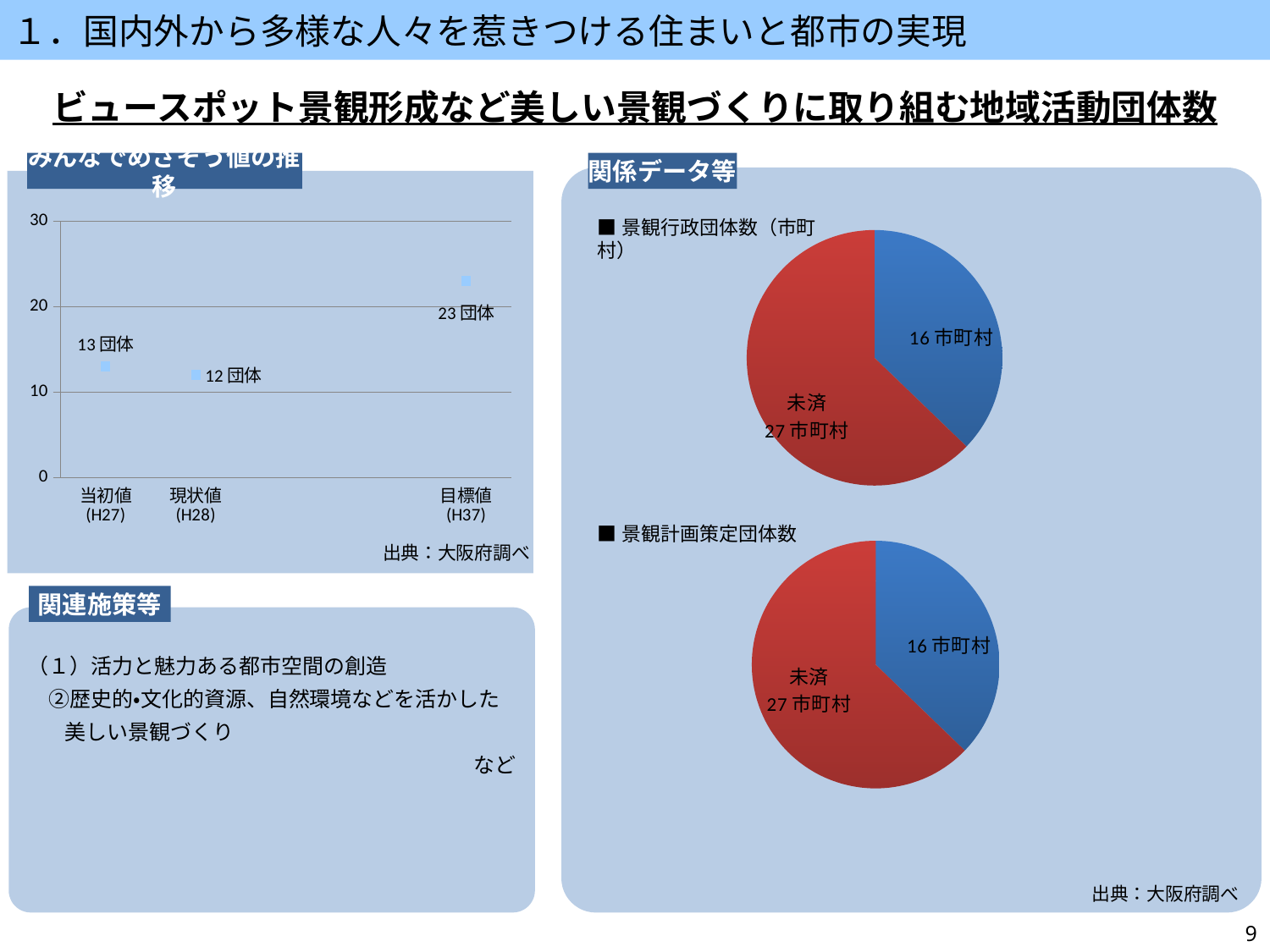
In the left chart titled みんなでめざそう値の推移, what is the difference between the 目標値 (H37) and the 現状値 (H28)? 11 団体 In the left chart titled みんなでめざそう値の推移, how many data points are plotted? 3 In the lower pie chart on the right (景観計画策定団体数), which slice is larger, 未済 or the blue slice? 未済 In the left chart titled みんなでめざそう値の推移, what is the value for 当初値 (H27)? 13 団体 In the left chart titled みんなでめざそう値の推移, what is the value for 目標値 (H37)? 23 団体 In the left chart titled みんなでめざそう値の推移, is the value for 目標値 (H37) greater or less than 20? greater What kind of chart is used for 景観計画策定団体数 on the right side of the slide? pie chart In the left chart titled みんなでめざそう値の推移, what is the value for 現状値 (H28)? 12 団体 In the upper pie chart on the right (景観行政団体数（市町村）), what is the value of the 未済 slice? 27 市町村 In the left chart titled みんなでめざそう値の推移, which category has the lowest value? 現状値 (H28) In the left chart titled みんなでめざそう値の推移, which category has the highest value? 目標値 (H37) In the upper pie chart on the right (景観行政団体数（市町村）), what is the total of the two slices? 43 市町村